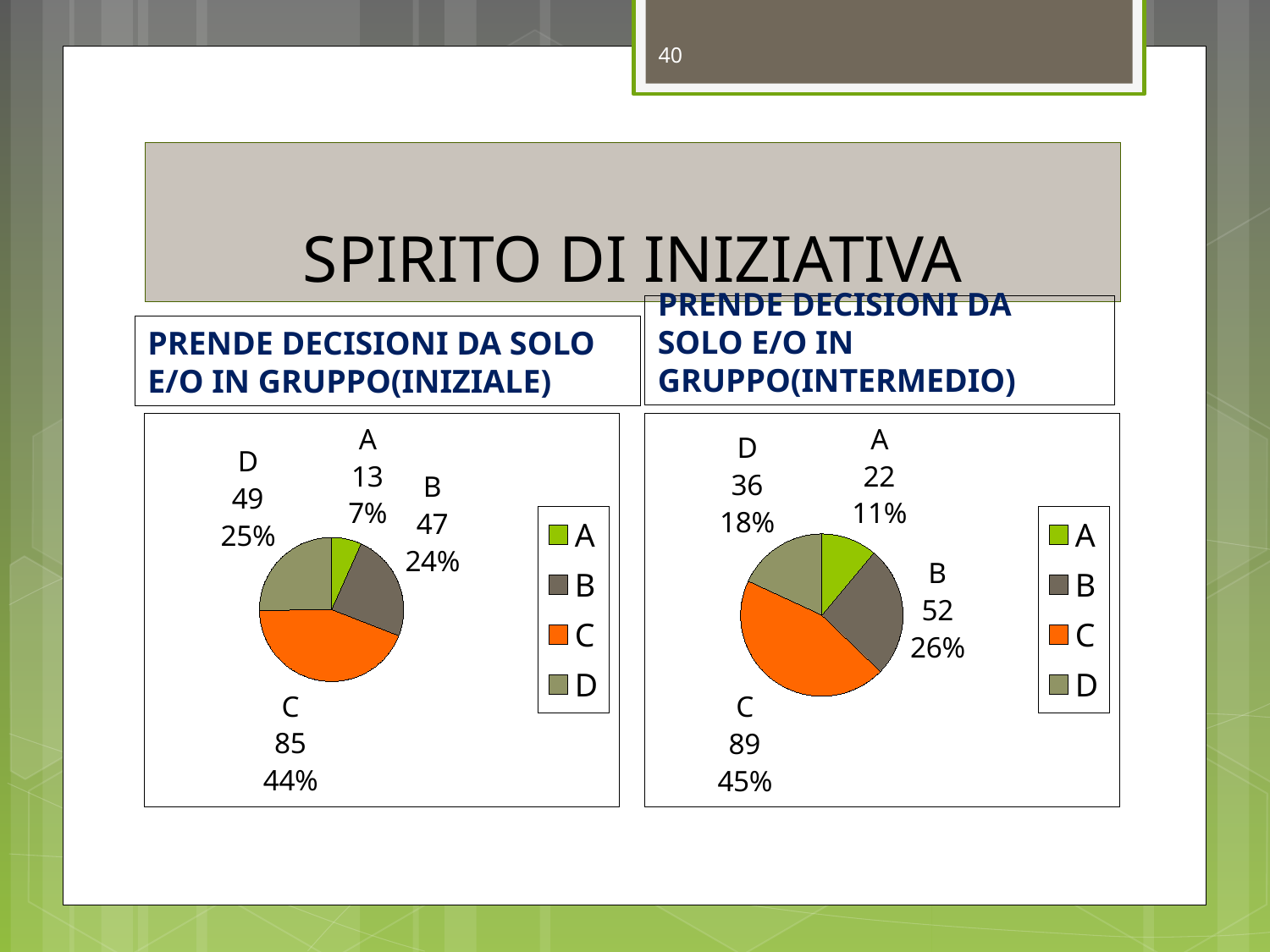
In the right pie chart (INTERMEDIO), which is larger, the value for B or the value for D? B In the right pie chart (INTERMEDIO), what percentage share does category C have? 45% In the left pie chart (INIZIALE), what percentage share does category D have? 25% How many categories does the left pie chart (INIZIALE) show? 4 In the right pie chart (INTERMEDIO), what is the difference between the values for B and D? 16 In the left pie chart (INIZIALE), which category has the largest slice? C In the left pie chart (INIZIALE), what is the value for category C? 85 In the left pie chart (INIZIALE), what is the difference between the values for C and B? 38 What type of chart is used on the right (INTERMEDIO)? Pie chart In the right pie chart (INTERMEDIO), what is the value for category A? 22 In the right pie chart (INTERMEDIO), which category has the smallest slice? A In the left pie chart (INIZIALE), what colour is the slice for category C? Orange